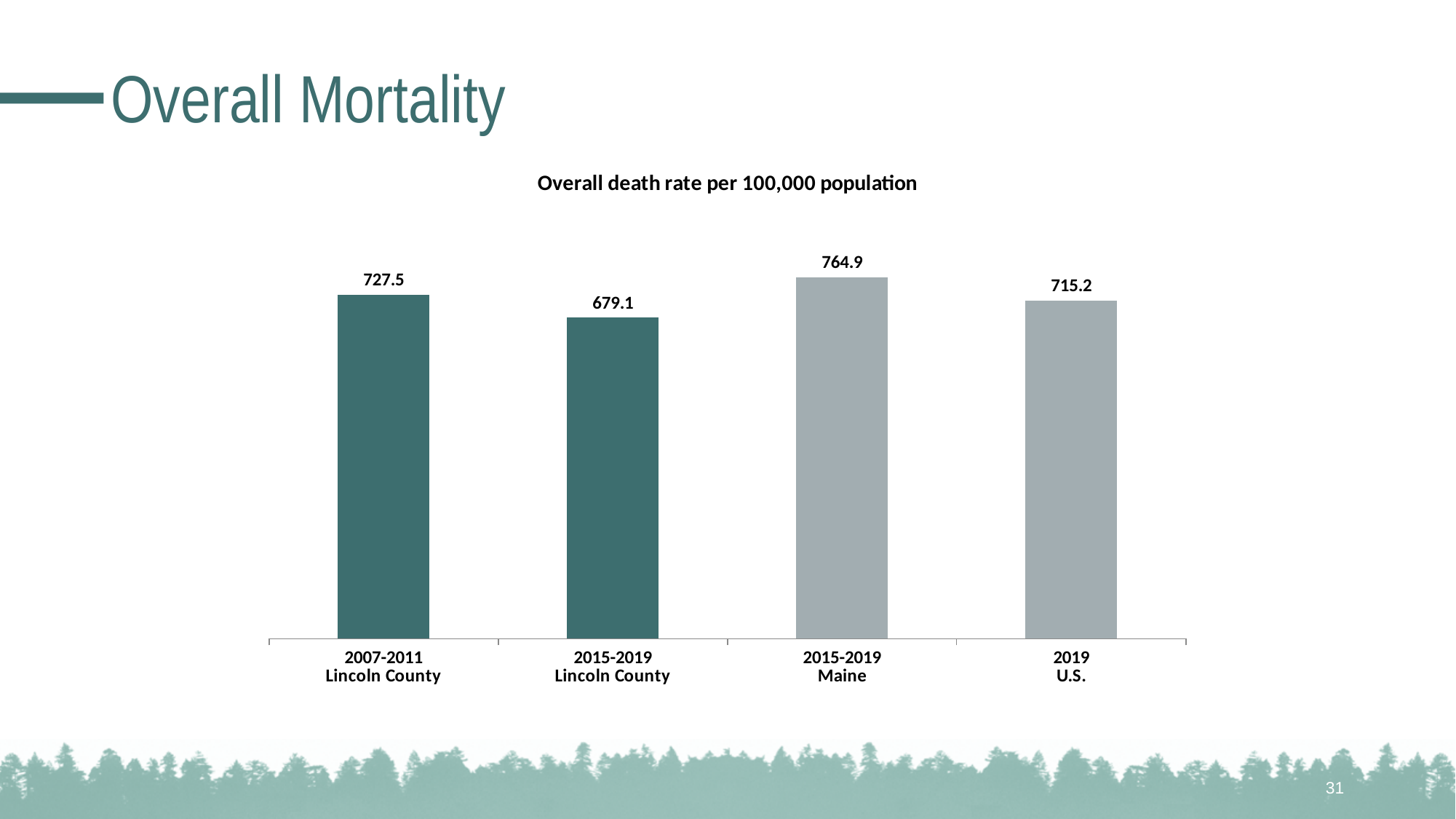
What is the overall death rate per 100,000 population for Lincoln County in 2015-2019? 679.1 Which is larger, the overall death rate for the U.S. in 2019 or for Lincoln County in 2015-2019? 2019 U.S. Which category has the highest overall death rate? 2015-2019 Maine What is the difference between the overall death rate for Maine in 2015-2019 and Lincoln County in 2015-2019? 85.8 What is the overall death rate per 100,000 population for Maine in 2015-2019? 764.9 What is the difference between the overall death rate for Lincoln County in 2007-2011 and in 2015-2019? 48.4 What is the overall death rate per 100,000 population for Lincoln County in 2007-2011? 727.5 What is the title of the chart? Overall death rate per 100,000 population What kind of chart is shown on the slide? Bar chart Which category has the lowest overall death rate? 2015-2019 Lincoln County What is the overall death rate per 100,000 population for the U.S. in 2019? 715.2 How many bars are shown in the chart? 4